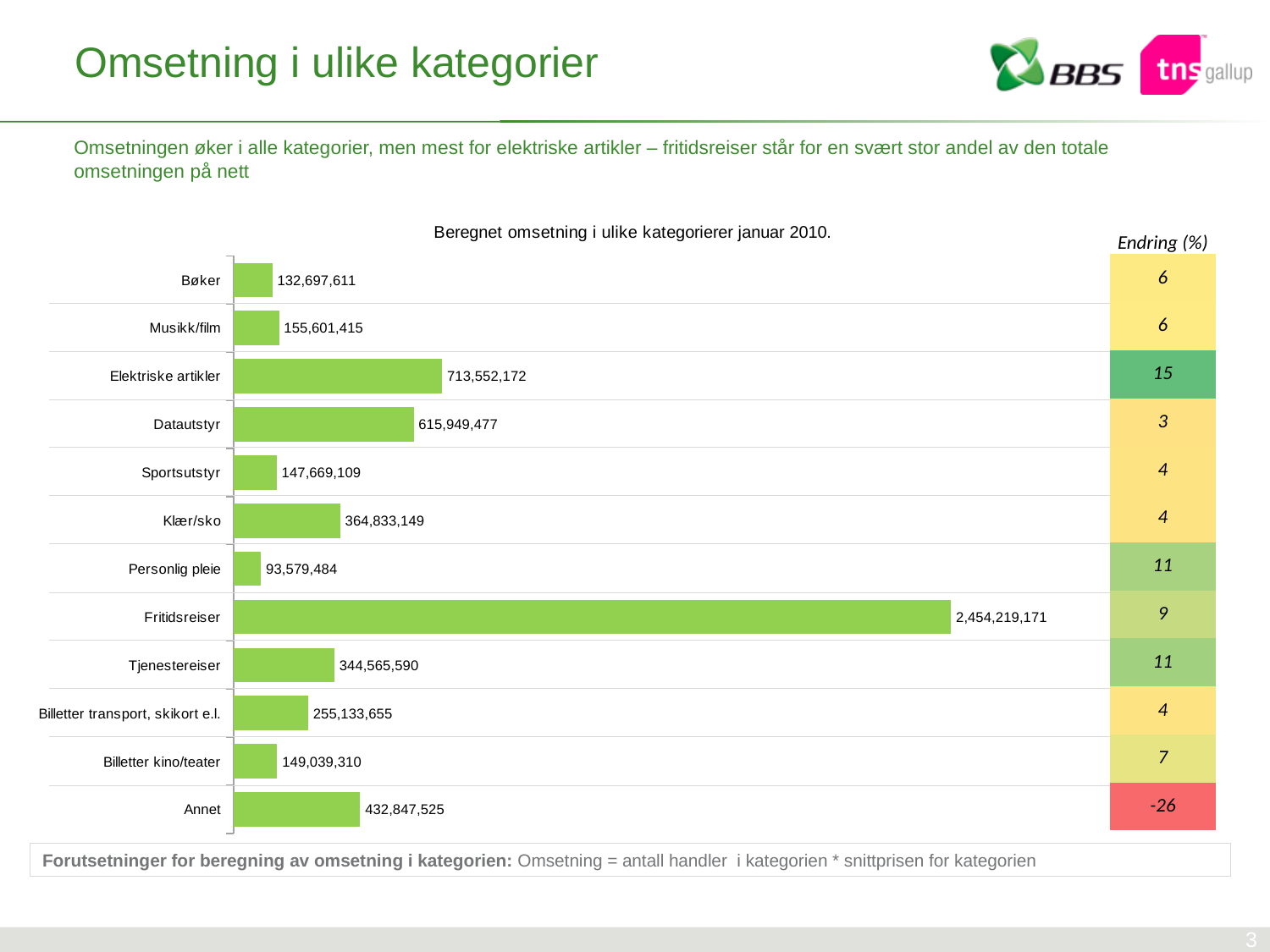
What is the value for Billetter transport, skikort e.l.? 255,133,655 Which is larger, the value for Klær/sko or the value for Tjenestereiser? Klær/sko What is the value for Fritidsreiser? 2,454,219,171 Which is larger, the value for Annet or the value for Klær/sko? Annet What is the value for Elektriske artikler? 713,552,172 How many categories are shown in the chart? 12 Which category has the highest value? Fritidsreiser What is the value for Personlig pleie? 93,579,484 Which category has the lowest value? Personlig pleie What is the difference between the values for Elektriske artikler and Datautstyr? 97,602,695 What is the difference between the values for Musikk/film and Bøker? 22,903,804 What type of chart is shown on the slide? Bar chart